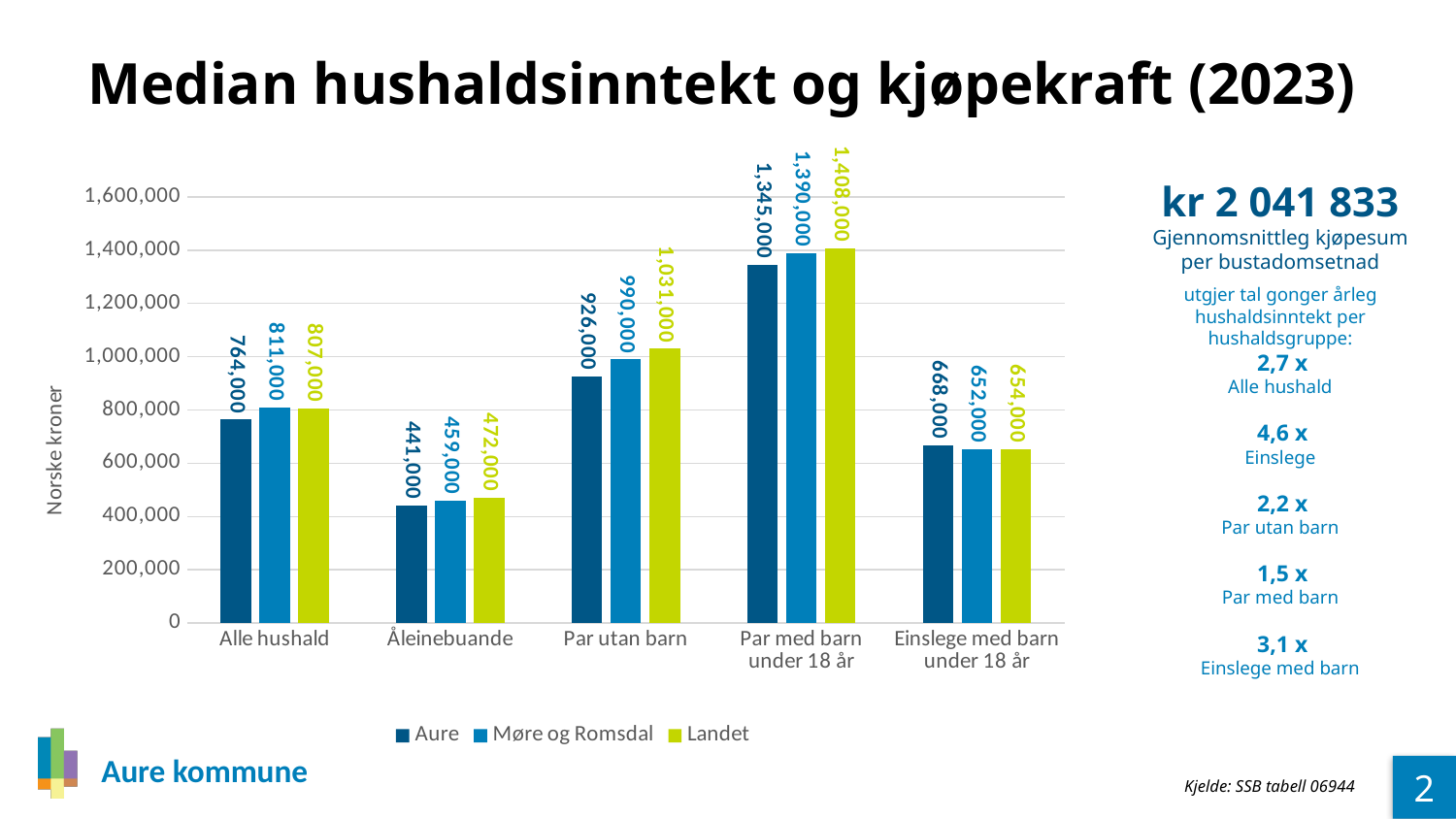
What kind of chart is shown on the slide? Bar chart Which category has the lowest value for Aure? Åleinebuande How many categories are shown on the x axis? 5 Which category has the highest value for Landet? Par med barn under 18 år What is the value for Møre og Romsdal in the Par med barn under 18 år category? 1,390,000 In the Einslege med barn under 18 år category, which is larger: Aure or Landet? Aure What is the value for Aure in the Einslege med barn under 18 år category? 668,000 What is the value for Landet in the Par utan barn category? 1,031,000 What is the difference between the Landet and Aure values in the Åleinebuande category? 31,000 How many series does the legend list? 3 What is the value for Aure in the Alle hushald category? 764,000 What is the difference between the Møre og Romsdal and Aure values in the Par utan barn category? 64,000